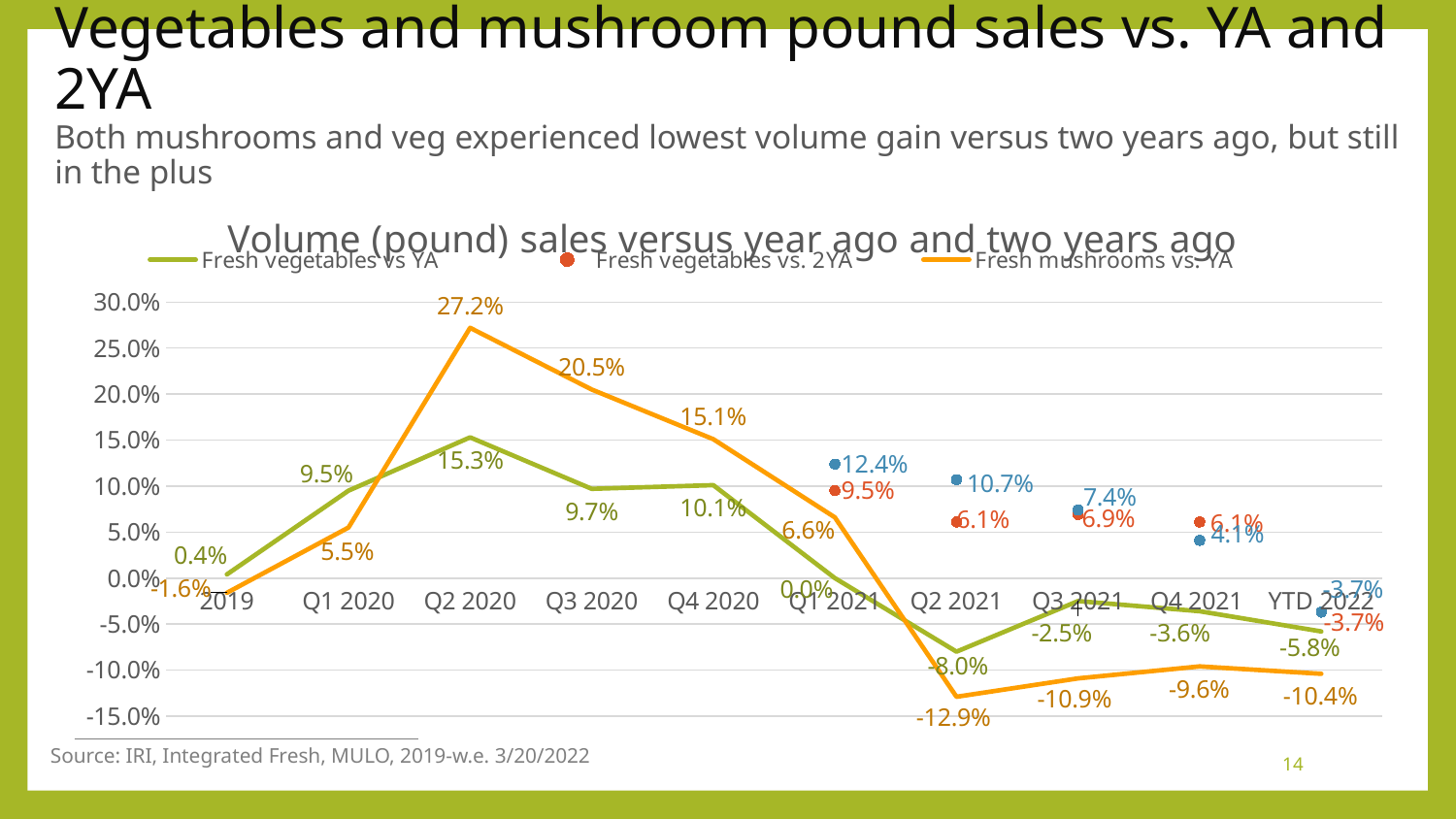
In which period is Fresh vegetables vs YA highest? Q2 2020 In which period is Fresh mushrooms vs. YA highest? Q2 2020 In Q2 2020, how many percentage points higher is Fresh mushrooms vs. YA than Fresh vegetables vs YA? 11.9 percentage points In which period is Fresh mushrooms vs. YA lowest? Q2 2021 What kind of chart is shown on the slide? Line chart Does Fresh mushrooms vs. YA rise or fall from Q2 2020 to Q2 2021? Fall How many periods are shown on the x axis? 10 What is the value for Fresh mushrooms vs. YA in Q2 2020? 27.2% What is the value for Fresh vegetables vs YA in Q2 2021? -8.0% In Q4 2020, which is larger: Fresh mushrooms vs. YA or Fresh vegetables vs YA? Fresh mushrooms vs. YA How many series does the legend list? 3 What is the value for Fresh vegetables vs. 2YA in Q3 2021? 6.9%